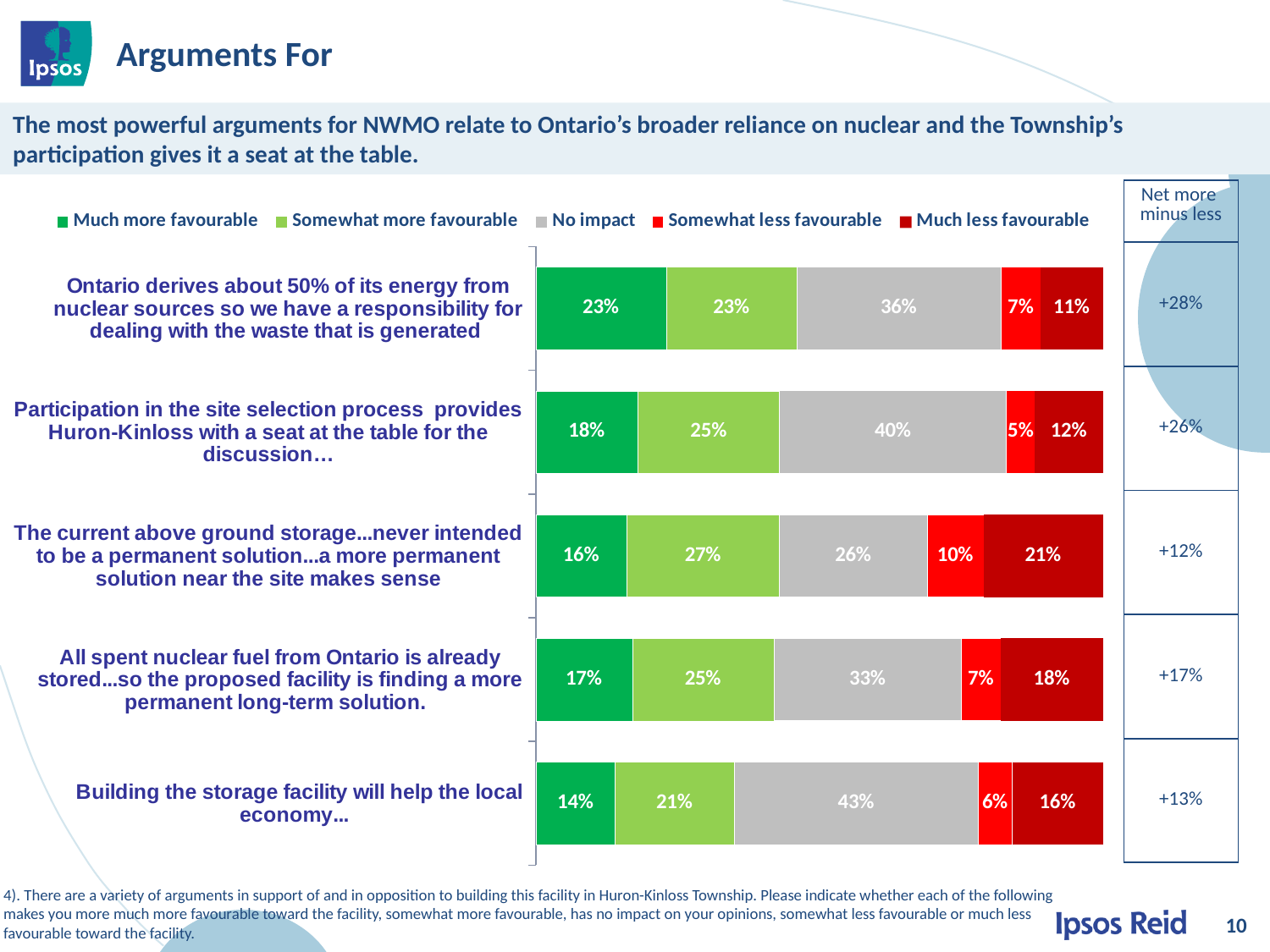
How many arguments (categories) are plotted in the chart? 5 Which colour represents 'No impact' in the chart? Grey Which argument has the highest 'Much more favourable' value? Ontario derives about 50% of its energy from nuclear sources so we have a responsibility for dealing with the waste that is generated What is the 'Net more minus less' value shown for 'Participation in the site selection process provides Huron-Kinloss with a seat at the table...'? +26% What is the difference in 'Much more favourable' between 'Ontario derives about 50% of its energy from nuclear sources...' and 'Building the storage facility will help the local economy...'? 9 percentage points Which argument has the lowest 'Much more favourable' value? Building the storage facility will help the local economy... What kind of chart is shown on the slide? Stacked bar chart Which has the larger 'No impact' value: 'Participation in the site selection process...' or 'All spent nuclear fuel from Ontario is already stored...'? Participation in the site selection process... How many series does the legend list? 5 What is the 'Somewhat more favourable' value for 'Participation in the site selection process provides Huron-Kinloss with a seat at the table...'? 25% What is the 'No impact' value for 'Building the storage facility will help the local economy...'? 43% What is the 'Much less favourable' value for 'The current above ground storage...never intended to be a permanent solution...'? 21%